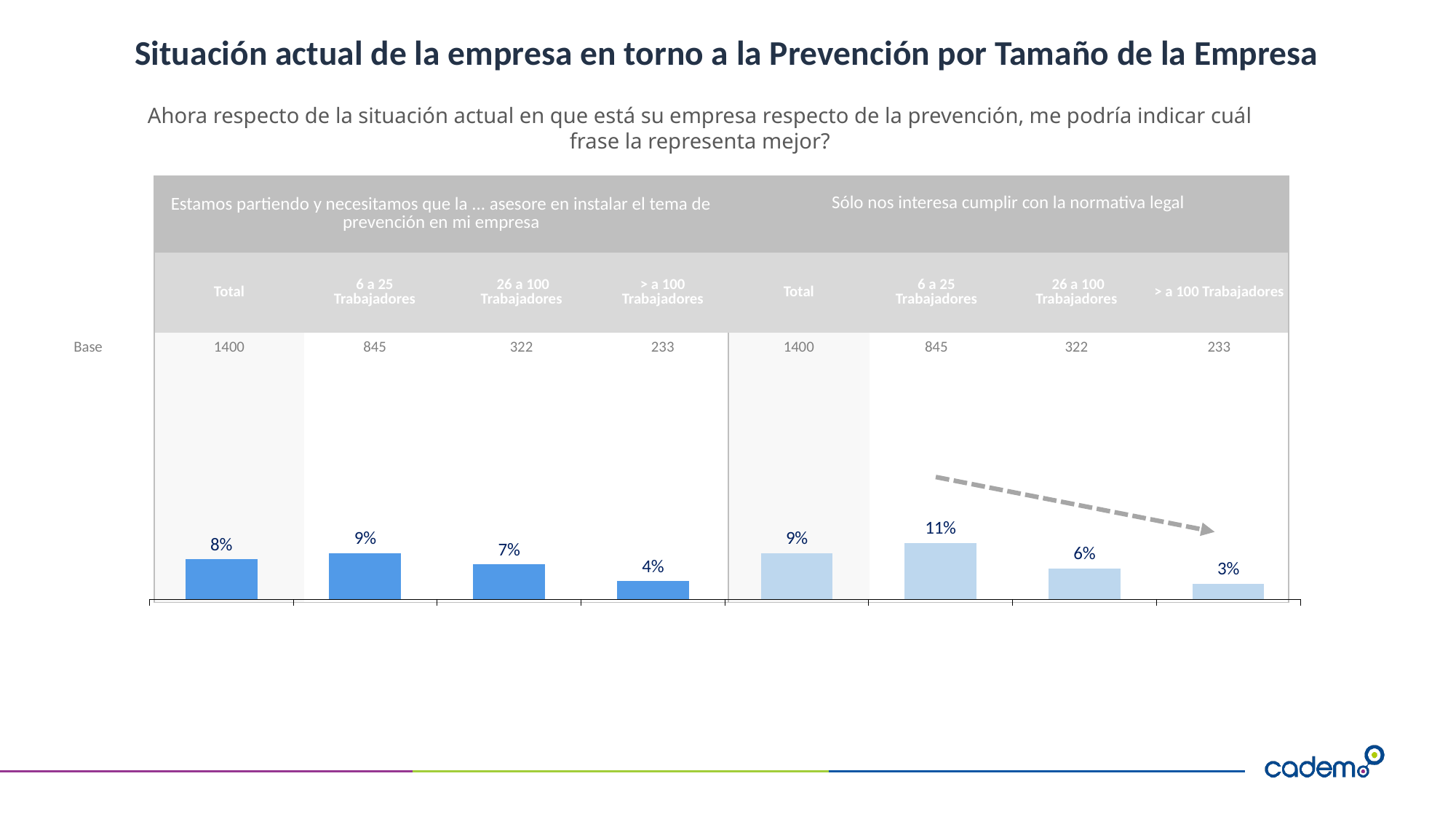
In the right chart ("Sólo nos interesa cumplir con la normativa legal"), which category has the lowest value? > a 100 Trabajadores In the right chart ("Sólo nos interesa cumplir con la normativa legal"), what is the difference between the values for 6 a 25 Trabajadores and > a 100 Trabajadores? 8% In the right chart ("Sólo nos interesa cumplir con la normativa legal"), what is the value for 26 a 100 Trabajadores? 6% In the right chart ("Sólo nos interesa cumplir con la normativa legal"), what is the value for 6 a 25 Trabajadores? 11% In the left chart ("Estamos partiendo..."), what is the value for > a 100 Trabajadores? 4% In the right chart ("Sólo nos interesa cumplir con la normativa legal"), do the values rise or fall from 6 a 25 Trabajadores to > a 100 Trabajadores? Fall In the left chart ("Estamos partiendo y necesitamos que la ... asesore..."), what is the value for Total? 8% What kind of chart is used on this slide? Bar chart Which is larger: the Total value in the left chart ("Estamos partiendo...") or the Total value in the right chart ("Sólo nos interesa cumplir con la normativa legal")? The right chart (9%) In the left chart ("Estamos partiendo..."), what is the difference between the values for 6 a 25 Trabajadores and 26 a 100 Trabajadores? 2% How many categories are shown in the right chart ("Sólo nos interesa cumplir con la normativa legal")? 4 In the left chart ("Estamos partiendo..."), which category has the highest value? 6 a 25 Trabajadores